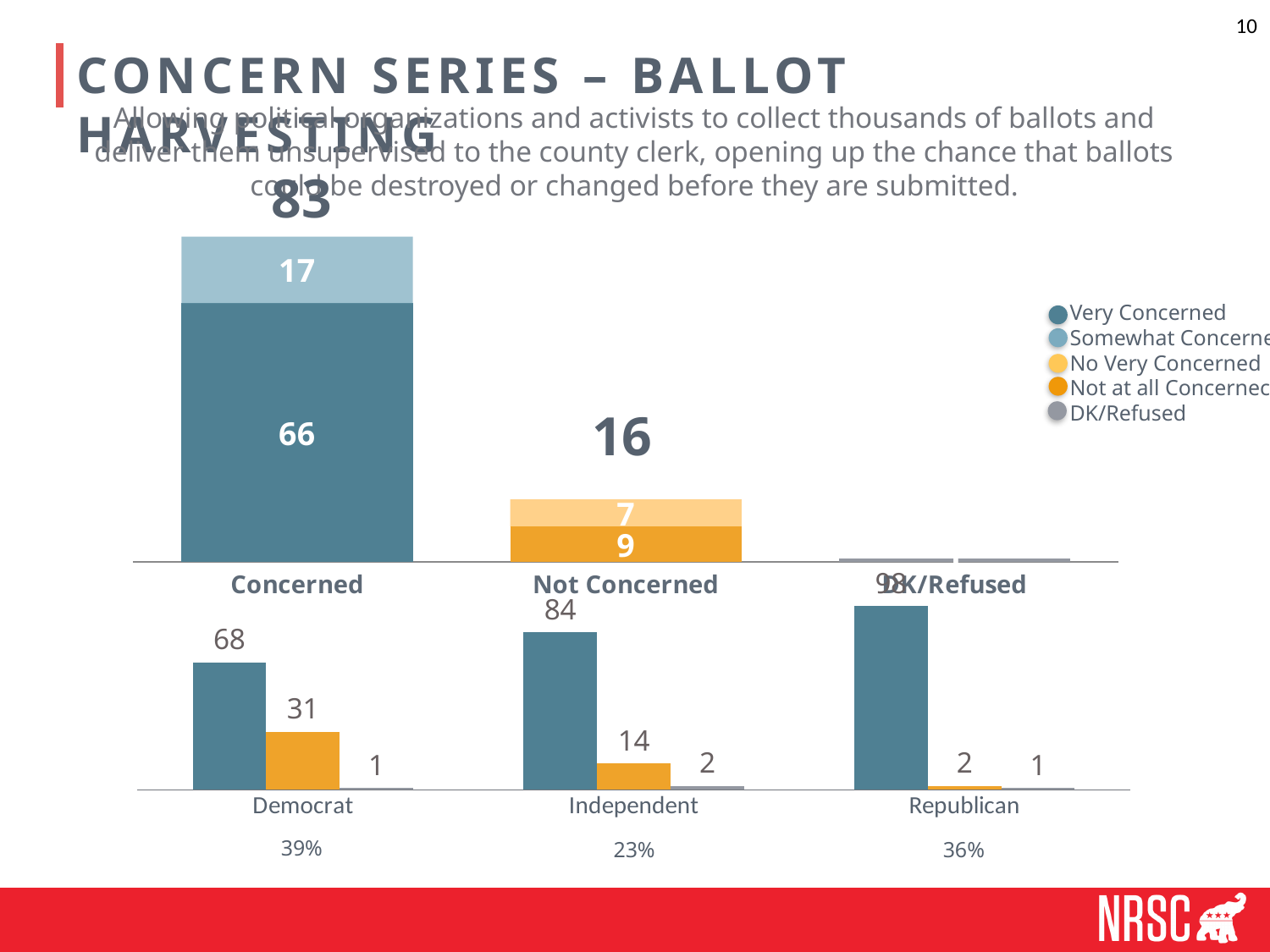
In the bottom chart by party, what is the Not at all Concerned value for Democrat? 31 In the bottom chart by party, which party has the highest Not at all Concerned value? Democrat In the top stacked bar chart, what is the total for the Not Concerned bar? 16 In the bottom chart by party, what is the Very Concerned value for Independent? 84 What kind of chart is the bottom chart by party? Bar chart How many entries does the legend on the slide list? 5 In the bottom chart by party, what is the Very Concerned value for Democrat? 68 In the top stacked bar chart, what is the Not at all Concerned value in the Not Concerned bar? 9 In the top stacked bar chart, what is the difference between the Concerned total and the Not Concerned total? 67 In the top stacked bar chart, what is the Very Concerned value in the Concerned bar? 66 In the top stacked bar chart, what is the Somewhat Concerned value in the Concerned bar? 17 In the top stacked bar chart, what is the total for the Concerned bar? 83